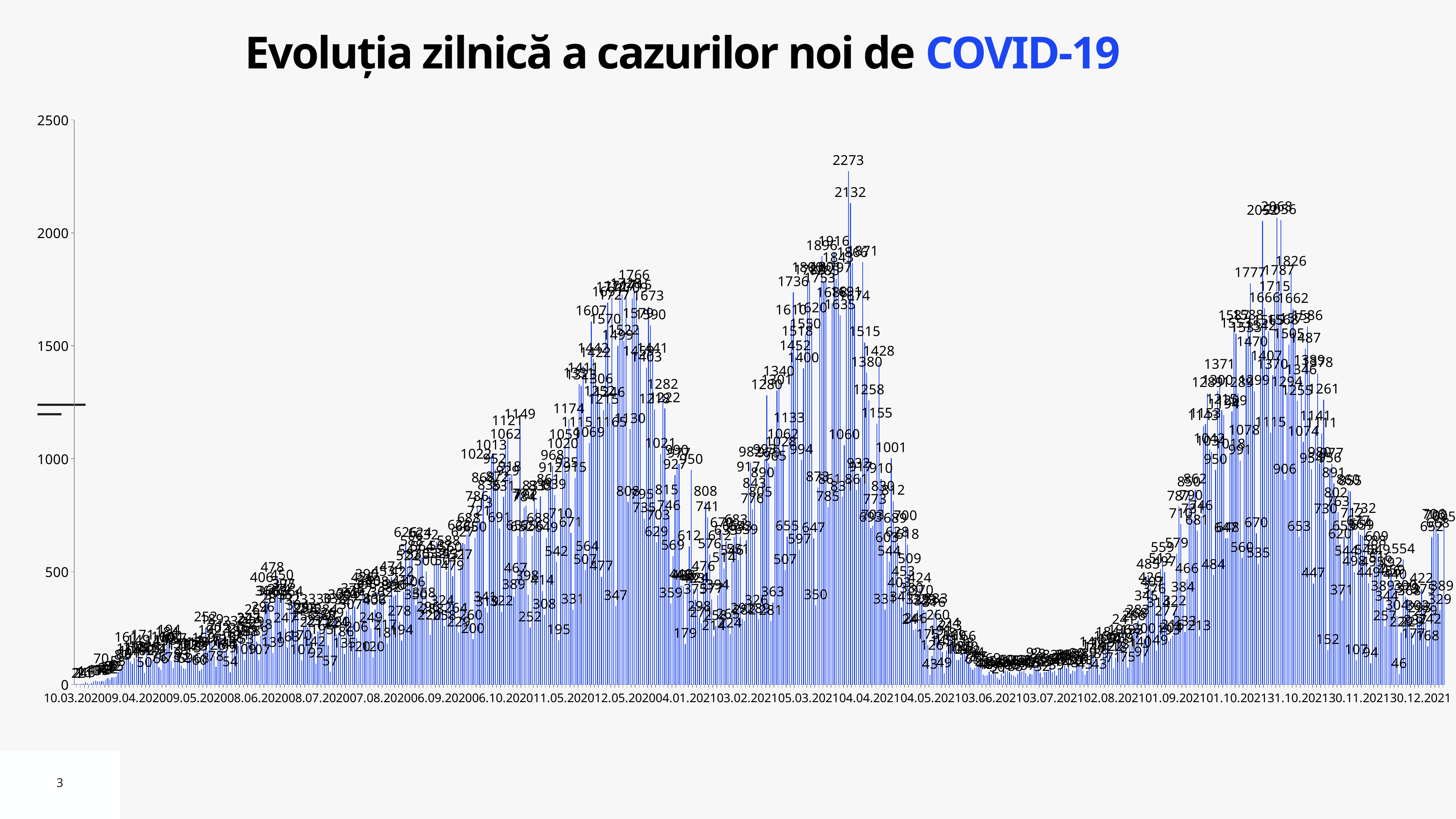
What is the difference between the two highest labeled values, 2273 and 2132? 141 What is the highest daily value labeled on the chart? 2273 Which is larger: the highest peak in April 2021 or the highest peak in late October 2021? the April 2021 peak (2273) Is the highest peak of the chart (around 04.04.2021) greater or less than 2000? greater Do the values rise or fall along the x axis between 04.04.2021 and 03.06.2021? fall Is the value for the first date on the x axis, 10.03.2020, greater or less than 500? less Are the values around 03.06.2021 and 03.07.2021 greater or less than 500? less What is the second-highest value labeled on the chart, next to the 2273 peak? 2132 What is the highest tick value shown on the vertical axis? 2500 What is the title of the chart on the slide? Evoluția zilnică a cazurilor noi de COVID-19 Do the values rise or fall along the x axis between 03.07.2021 and 01.10.2021? rise What kind of chart is shown on the slide? bar chart